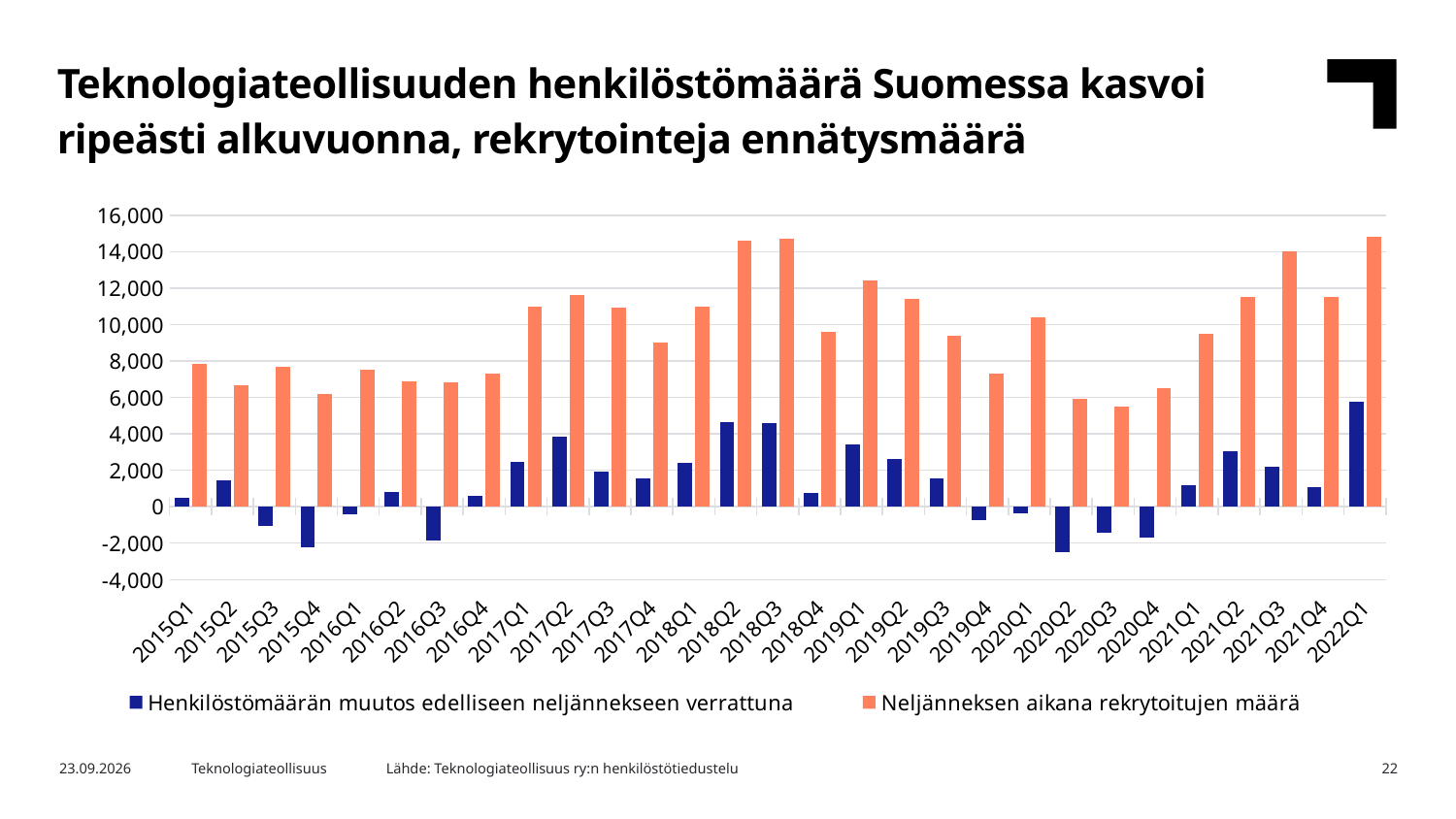
Which quarter has the larger value for Henkilöstömäärän muutos edelliseen neljännekseen verrattuna, 2017Q2 or 2017Q3? 2017Q2 How many quarters are shown on the x axis? 29 Is the value of Neljänneksen aikana rekrytoitujen määrä for 2017Q1 greater or less than 10,000? greater Is the value of Neljänneksen aikana rekrytoitujen määrä for 2022Q1 greater or less than 14,000? greater Is the value of Henkilöstömäärän muutos edelliseen neljännekseen verrattuna for 2018Q2 greater or less than 4,000? greater What kind of chart is shown on the slide? bar chart Which quarter has the highest value for Henkilöstömäärän muutos edelliseen neljännekseen verrattuna? 2022Q1 Does the value of Neljänneksen aikana rekrytoitujen määrä rise or fall from 2020Q3 to 2021Q3? rise How many series does the legend list? 2 Which quarter has the larger value for Neljänneksen aikana rekrytoitujen määrä, 2018Q2 or 2020Q1? 2018Q2